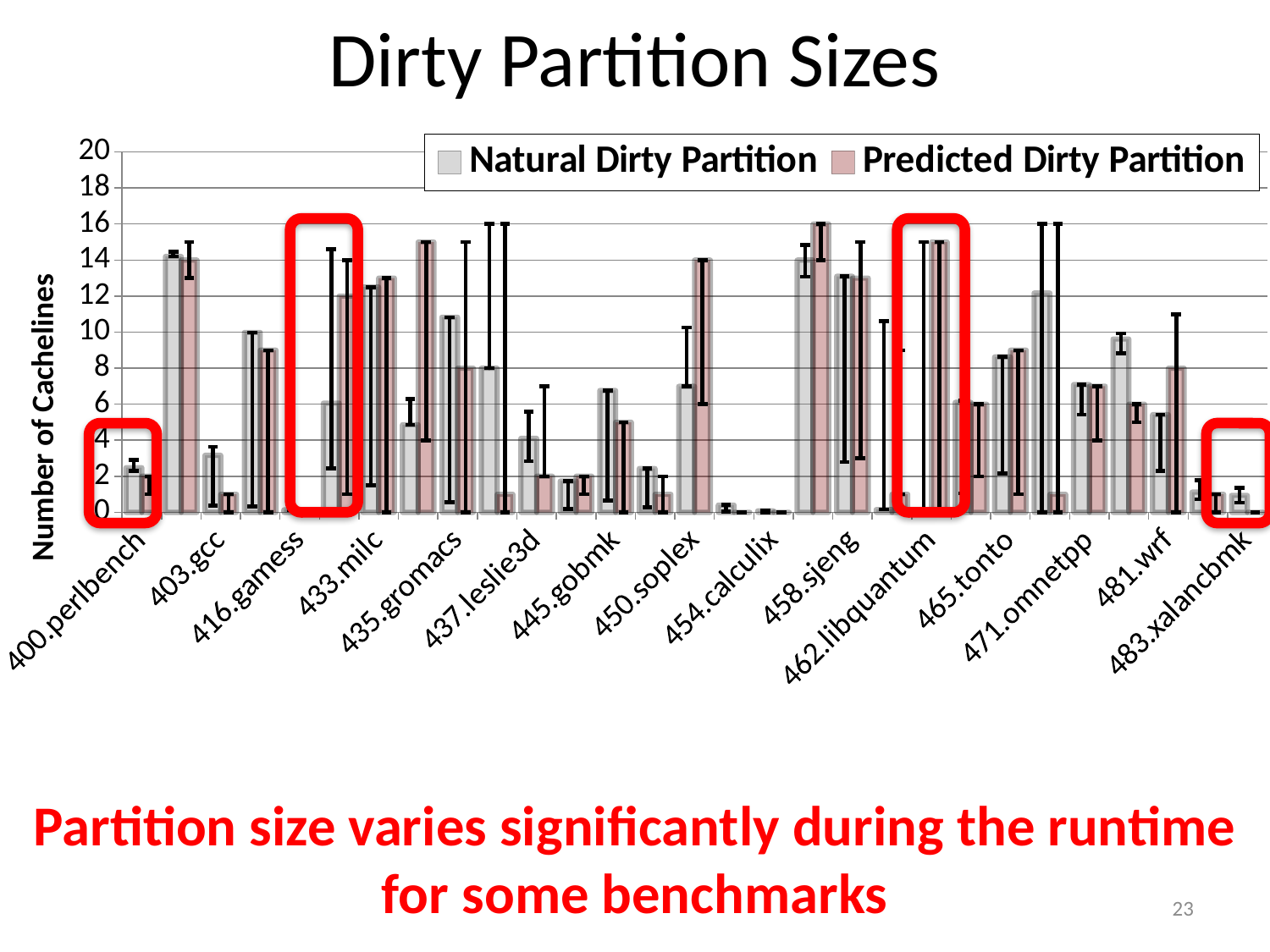
For 450.soplex, which is larger: the Natural Dirty Partition or the Predicted Dirty Partition? Predicted Dirty Partition What are the two series named in the legend? Natural Dirty Partition and Predicted Dirty Partition Is the Predicted Dirty Partition value for 450.soplex greater or less than 10? greater Which has the larger Natural Dirty Partition value: 458.sjeng or 454.calculix? 458.sjeng Is the Predicted Dirty Partition value for 462.libquantum greater or less than 10? greater What is the title of the chart? Dirty Partition Sizes Is the Natural Dirty Partition value for 403.gcc greater or less than 10? less Which has the larger Natural Dirty Partition value: 403.gcc or 400.perlbench? 403.gcc How many series does the legend list? 2 What type of chart is shown on the slide? bar chart